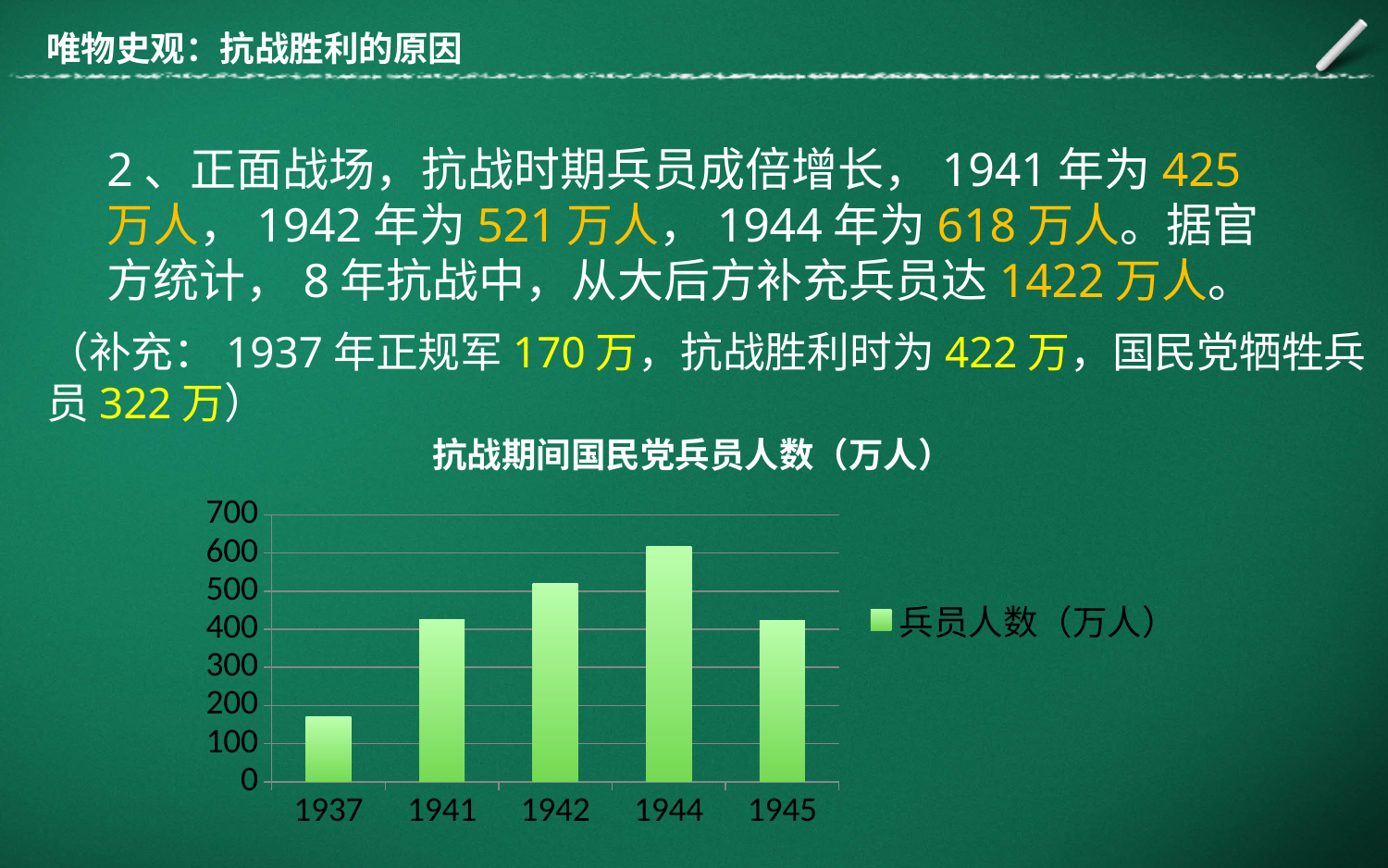
What is the title of the chart? 抗战期间国民党兵员人数（万人） Which year has the lowest bar in the chart? 1937 How many series does the chart legend list? 1 Is the value for 1944 greater or less than 600? greater Which year has the highest bar in the chart? 1944 Is the value for 1945 greater or less than 500? less What kind of chart is shown on the slide? bar chart Is the value for 1942 greater or less than 500? greater Which year has the larger value, 1942 or 1941? 1942 How many years are shown on the x axis of the chart? 5 Do the values rise or fall from 1937 to 1944? rise